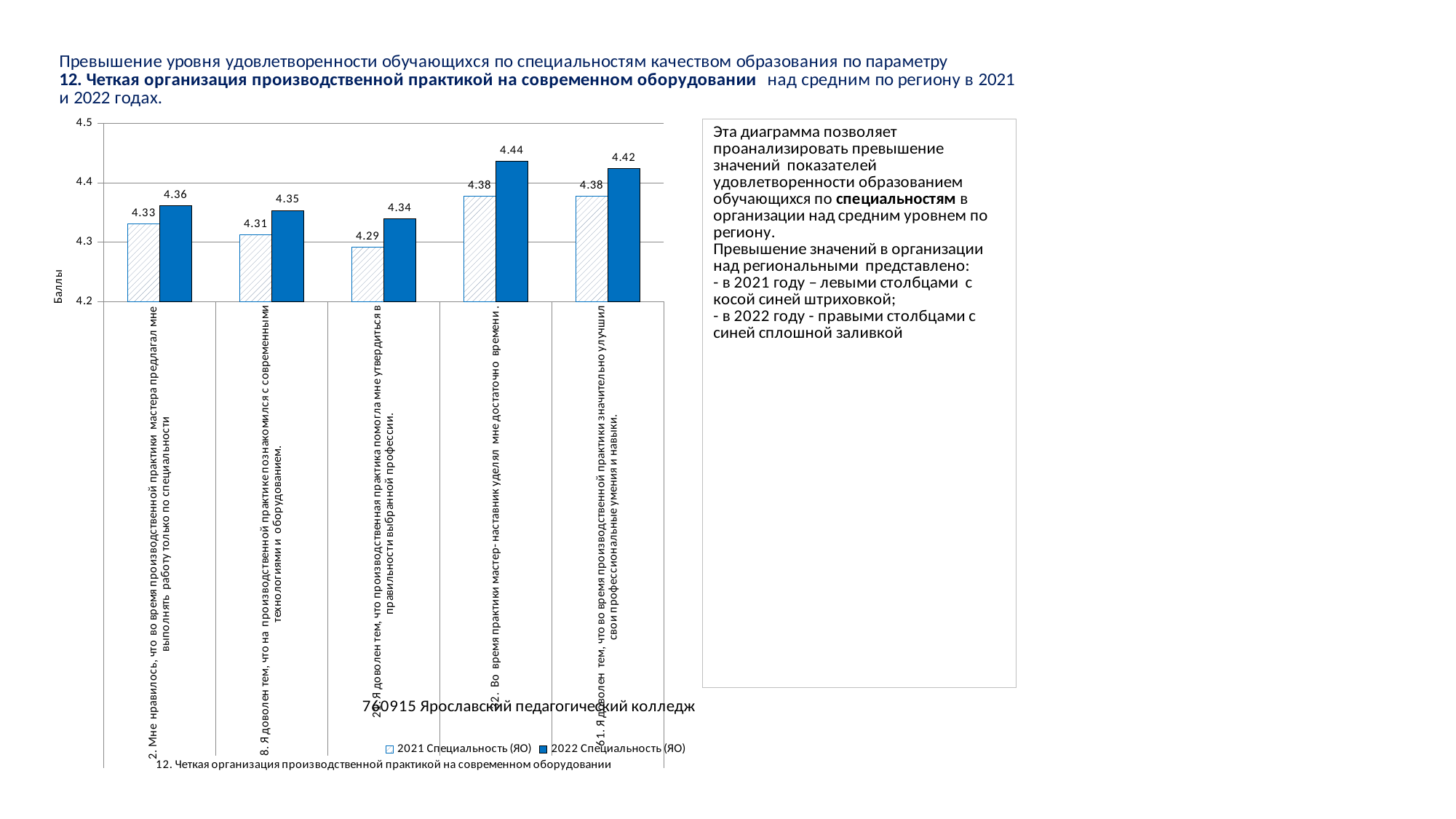
Which category has the lowest 2021 Специальность (ЯО) value? 21. Я доволен тем, что производственная практика помогла мне утвердиться в правильности выбранной профессии What is the difference between the 2022 and 2021 values for category 2 (мастер предлагал мне выполнять работу только по специальности)? 0.03 What type of chart is shown on the slide? Bar chart Which is larger for category 61 (значительно улучшил свои профессиональные умения и навыки): the 2021 value or the 2022 value? 2022 value (4.42) What is the difference between the 2022 and 2021 values for category 32 (мастер-наставник уделял мне достаточно времени)? 0.06 Which category has the highest 2022 Специальность (ЯО) value? 32. Во время практики мастер-наставник уделял мне достаточно времени Is the 2022 Специальность (ЯО) value for category 32 greater or less than 4.4? greater How many series does the chart legend list? 2 What is the 2021 Специальность (ЯО) value for category 8 (Я доволен тем, что на производственной практике познакомился с современными технологиями и оборудованием)? 4.31 What is the 2021 Специальность (ЯО) value for category 20 (Я доволен тем, что производственная практика помогла мне утвердиться в правильности выбранной профессии)? 4.29 How many categories are shown on the x axis of the chart? 5 What is the 2022 Специальность (ЯО) value for category 32 (Во время практики мастер-наставник уделял мне достаточно времени)? 4.44